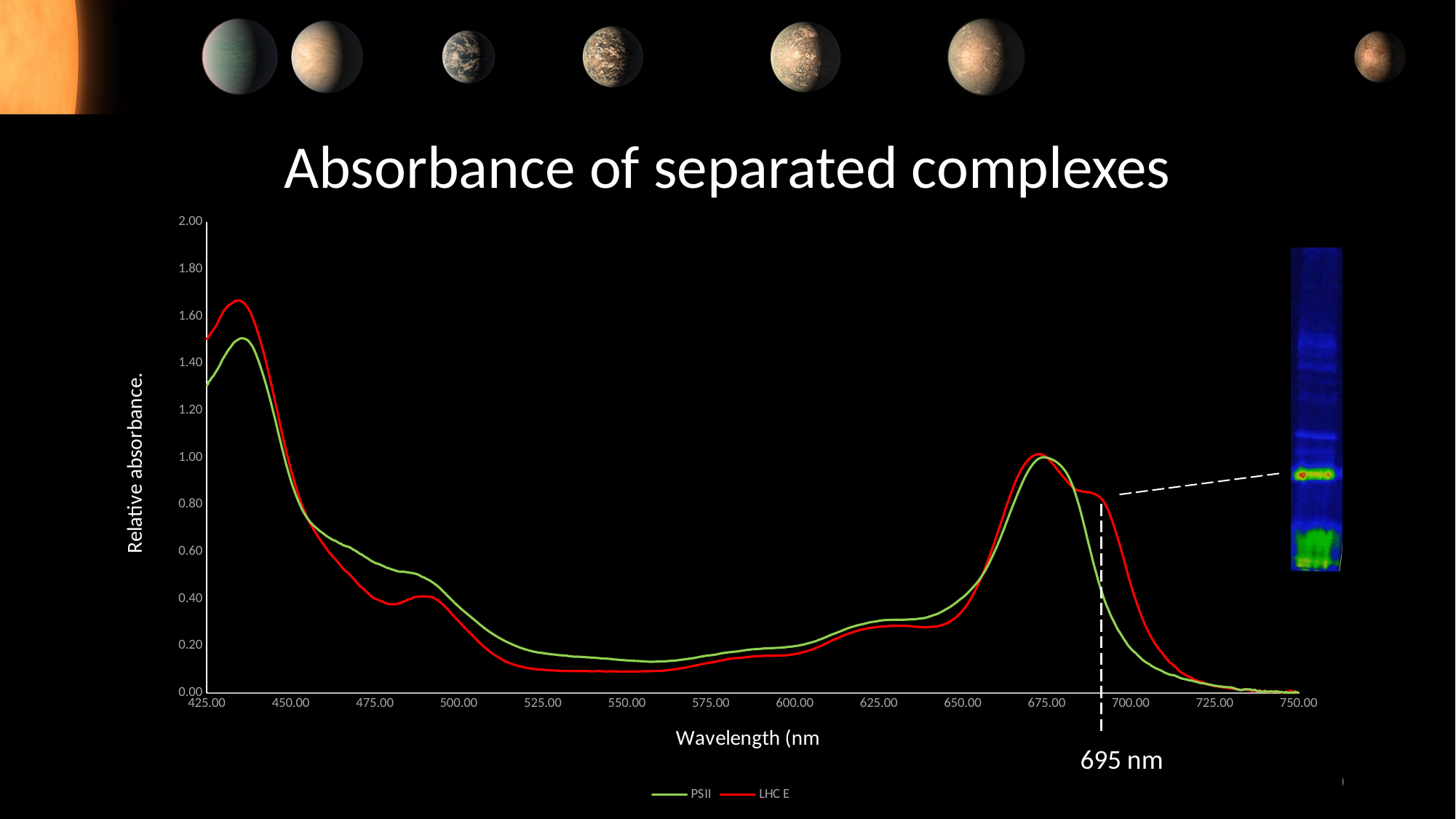
Is the value of PSII at 725 nm greater or less than 0.20? less At 475 nm, which series has the higher relative absorbance, PSII or LHC E? PSII Is the peak value of LHC E near 435 nm greater or less than 1.40? greater Is the value of PSII at 550 nm greater or less than 0.40? less What kind of chart is shown on the slide? line chart Do the values of PSII rise or fall between 650 nm and 675 nm? rise At 695 nm, which series has the higher relative absorbance, PSII or LHC E? LHC E What is the title of the chart on the slide? Absorbance of separated complexes Do the values of LHC E rise or fall between 450 nm and 525 nm? fall How many series does the chart's legend list? 2 Which series is drawn in red in the chart? LHC E